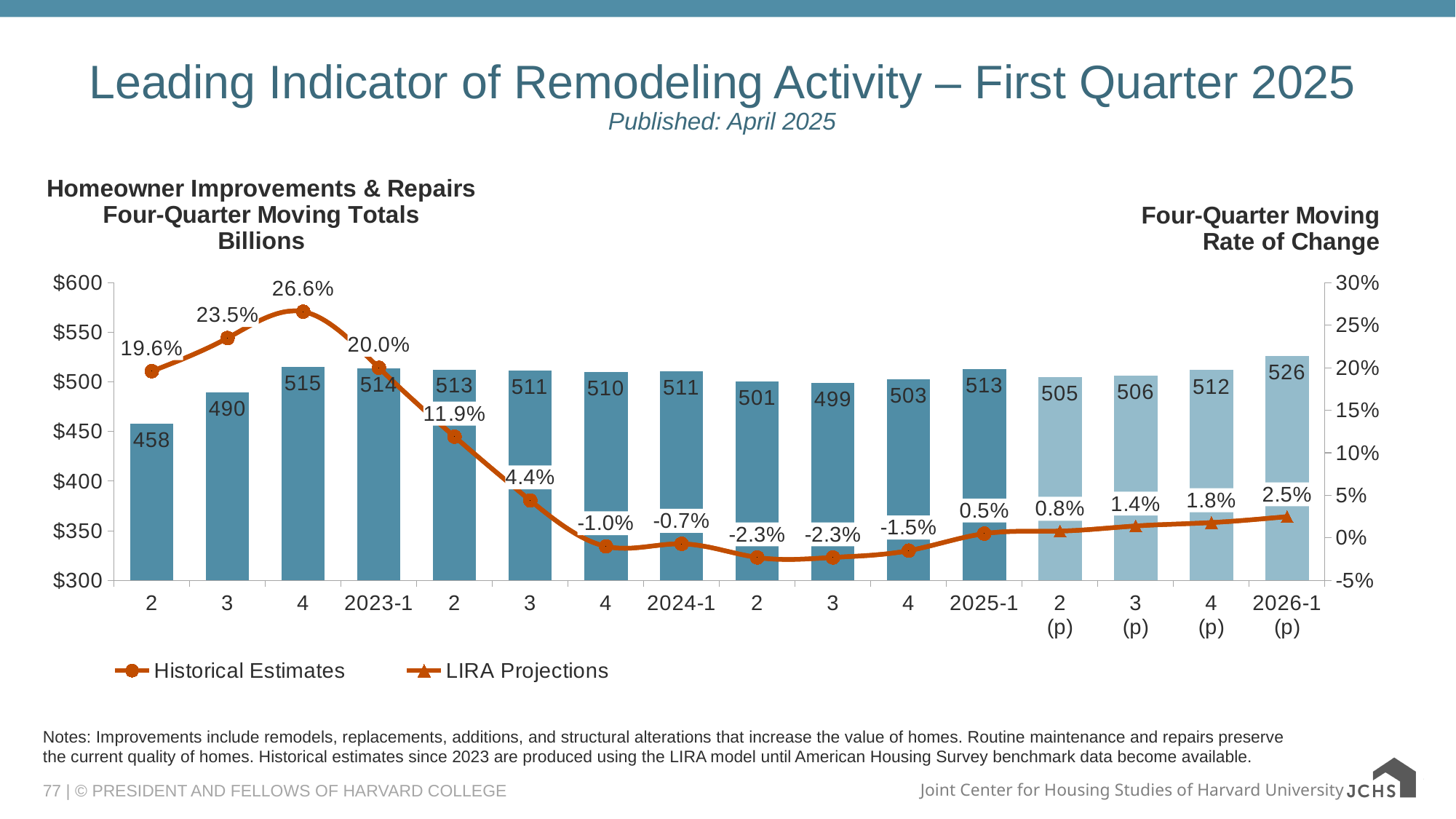
Which period has the highest four-quarter moving total bar? 2026-1 (p) How many bars are plotted in the chart? 16 What is the four-quarter moving total (in billions) shown for 2025-1? 513 Which has the larger four-quarter moving total, 2024-1 or 2025-1? 2025-1 How many series does the legend list? 2 Does the four-quarter moving rate of change rise or fall from 2024-1 to 2026-1 (p)? Rises What is the difference between the four-quarter moving total for 2026-1 (p) and for 2025-1? 13 What is the lowest four-quarter moving total value shown on the bars? 458 What is the highest four-quarter moving rate of change value shown on the line? 26.6% What is the projected rate of change shown for 3 (p)? 1.4% What kind of chart is shown on the slide? Combined bar and line chart What is the four-quarter moving rate of change shown for 2023-1? 20.0%